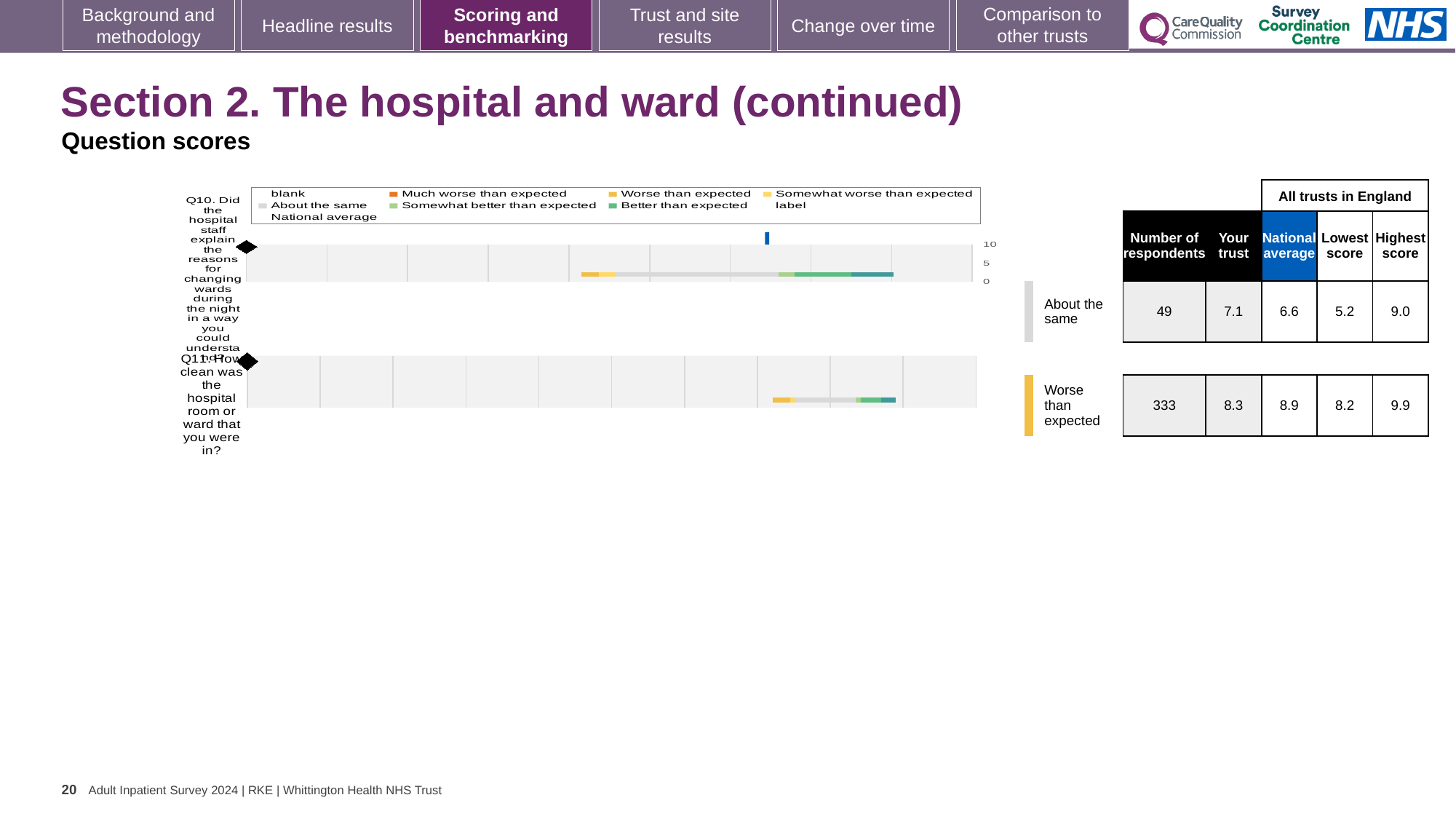
What is the maximum value shown on the score axis of the Q10 chart? 10 What is the highest score among all trusts in England for Q10? 9.0 Which benchmark category is Q11 placed in? Worse than expected How many survey questions are plotted on the slide? 2 For Q10, what is the difference between the trust's score and the national average? 0.5 What is the 'Your trust' score for Q10 (explaining reasons for changing wards during the night)? 7.1 What kind of chart is used to show the question scores for Q10 and Q11? bar chart What is the national average score for Q11 (how clean was the hospital room or ward)? 8.9 Which question has the higher 'Your trust' score, Q10 or Q11? Q11 For Q11, what is the difference between the highest and lowest scores across all trusts in England? 1.7 For Q11, which is larger: the trust's score or the national average? National average How many respondents answered Q10? 49